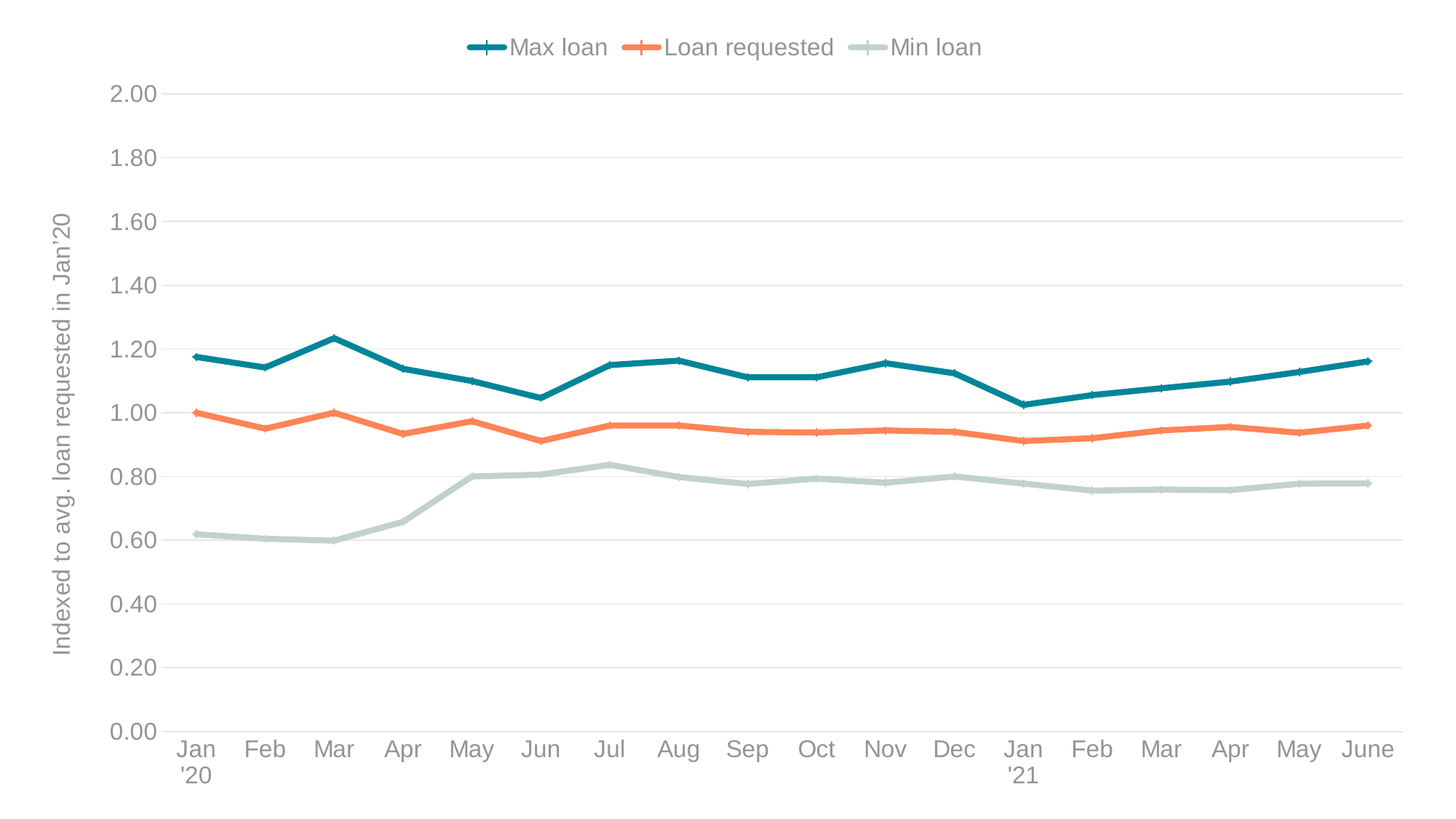
What is the label on the y axis? Indexed to avg. loan requested in Jan'20 What kind of chart is shown on the slide? line chart Is the value for Max loan in Jun '20 greater or less than 1.20? less In which month does the Max loan series reach its highest value? Mar '20 How many months are plotted along the x axis? 18 Does the Min loan series rise or fall from Mar '20 to Jul '20? rise Is the value for Max loan in Mar '20 greater or less than 1.20? greater How many series does the legend list? 3 In which month does the Min loan series reach its highest value? Jul '20 What is the value of Loan requested in Jan '20? 1.00 Which is larger in Jun '21, Max loan or Min loan? Max loan Is the value for Min loan in Apr '20 greater or less than 0.80? less